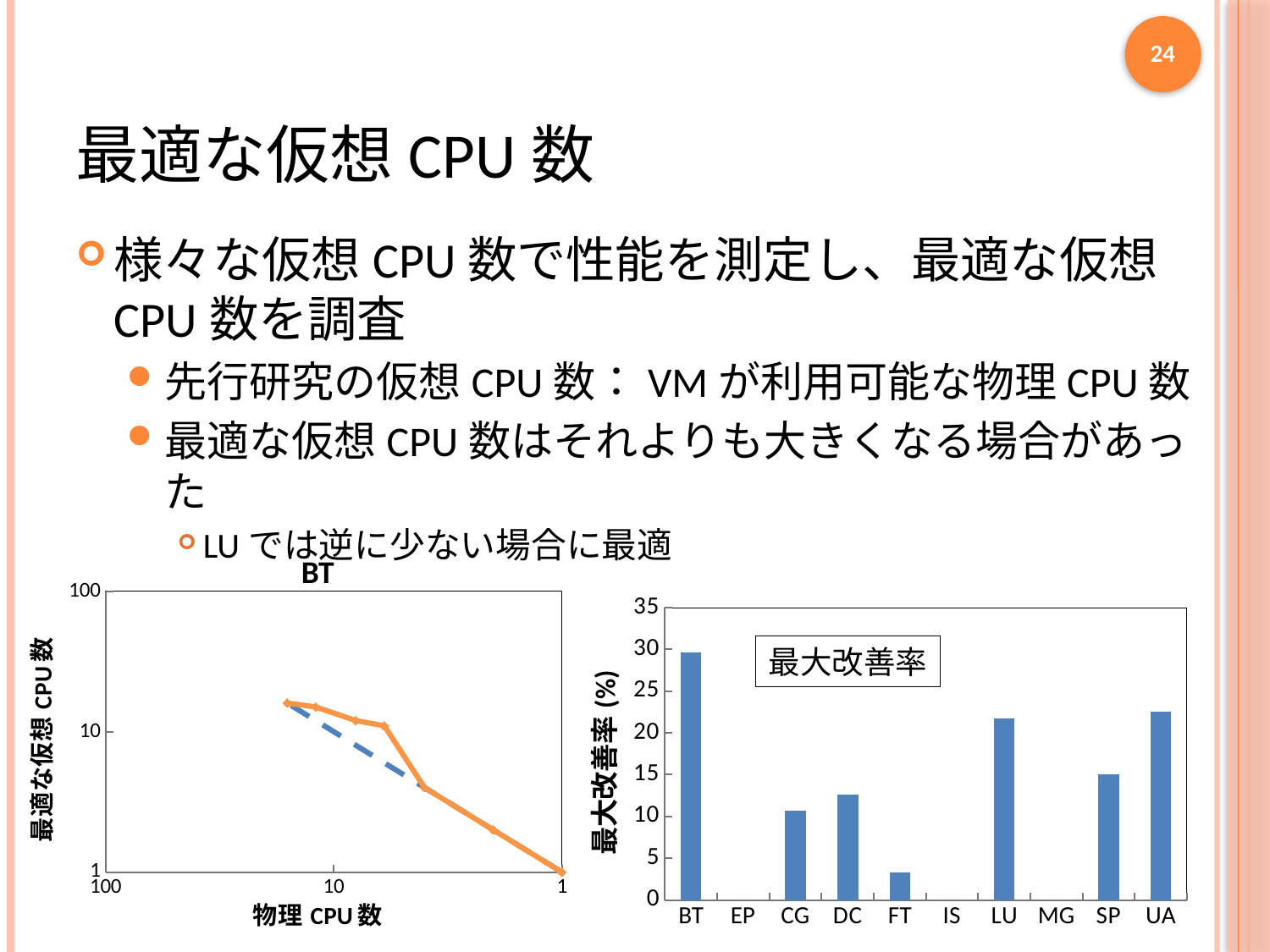
In the bar chart on the right, how many categories are shown on the x axis? 10 In the bar chart on the right, is the value for BT greater or less than 25? greater In the bar chart on the right, is the value for CG greater or less than 15? less In the bar chart on the right, which category has the highest 最大改善率? BT In the bar chart on the right, which is larger, the value for BT or the value for UA? BT In the bar chart on the right, is the value for LU greater or less than 20? greater What kind of chart is the chart on the left of the slide titled BT? line chart What kind of chart is the chart on the right of the slide (最大改善率)? bar chart In the line chart on the left titled BT, do the plotted values rise or fall from left to right along the x axis? fall In the bar chart on the right, which is larger, the value for SP or the value for FT? SP What is the x-axis label of the line chart on the left titled BT? 物理 CPU 数